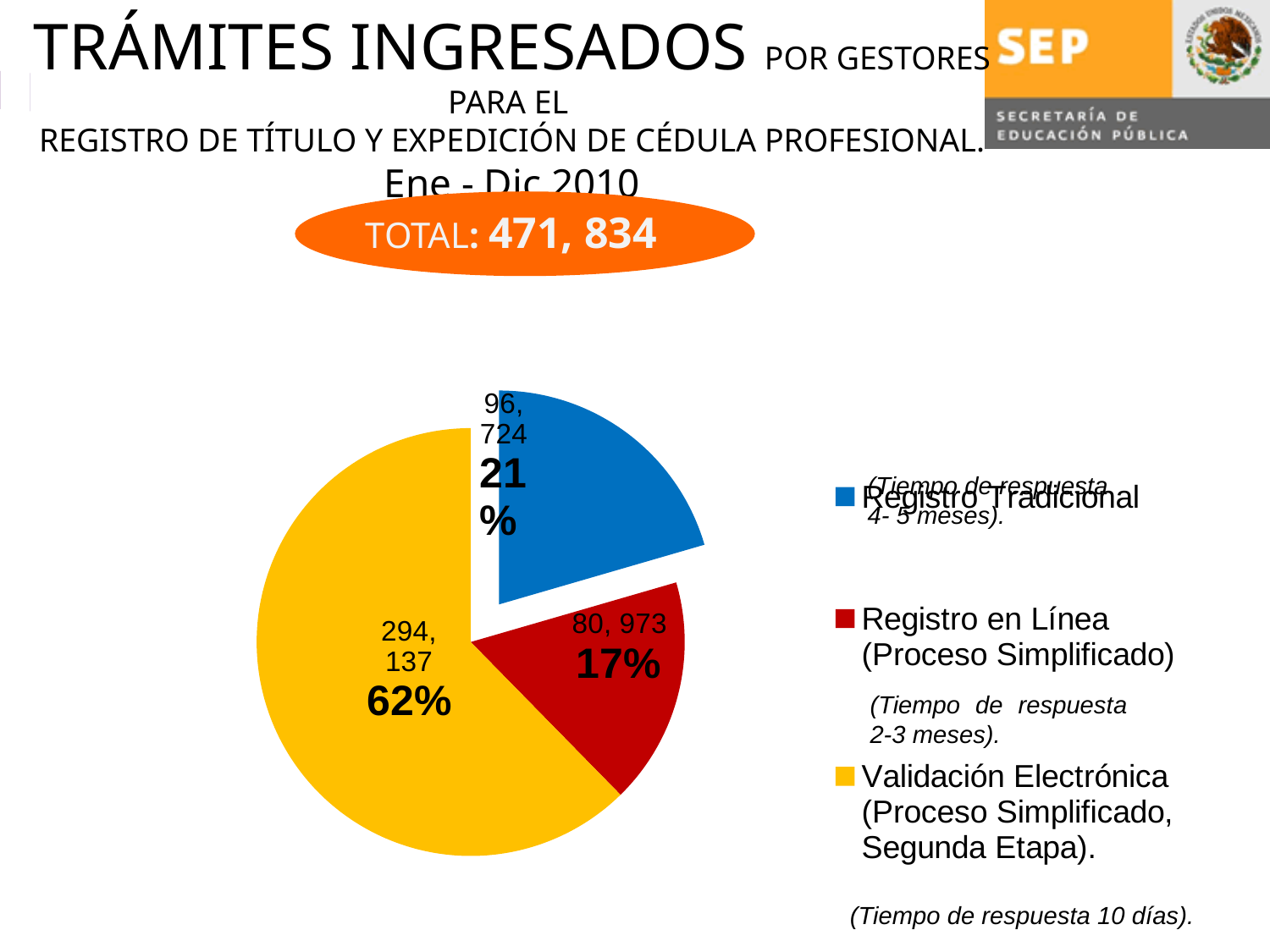
Which category has the smallest slice of the pie? Registro en Línea (Proceso Simplificado) What is the difference between the values for Validación Electrónica and Registro en Línea? 213,164 What share of the pie does Validación Electrónica represent? 62% What kind of chart is shown on the slide? pie chart What colour is the slice for Registro Tradicional? blue What share of the pie does Registro Tradicional represent? 21% How many slices does the pie chart have? 3 How many entries does the legend list? 3 What is the value for Registro en Línea (Proceso Simplificado)? 80,973 What is the value for Validación Electrónica (Proceso Simplificado, Segunda Etapa)? 294,137 What is the value for Registro Tradicional? 96,724 Which category has the largest slice of the pie? Validación Electrónica (Proceso Simplificado, Segunda Etapa)